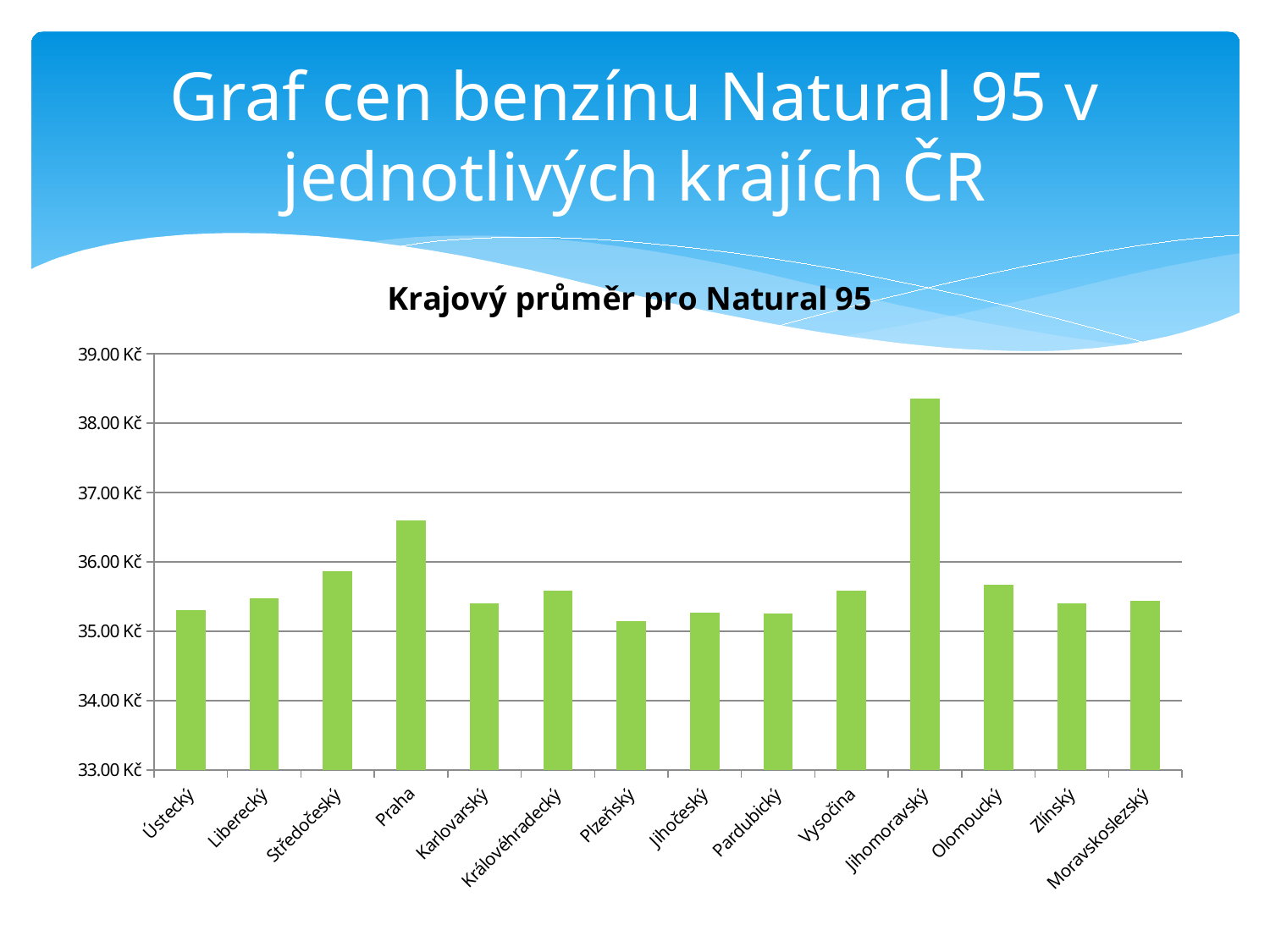
Is the value for Plzeňský greater or less than 35.00 Kč? greater Which is larger, the value for Jihomoravský or the value for Praha? Jihomoravský Is the value for Jihomoravský greater or less than 38.00 Kč? greater What colour are the bars in the chart? green Is the value for Ústecký greater or less than 36.00 Kč? less What is the title of the chart? Krajový průměr pro Natural 95 Which region has the highest average price for Natural 95? Jihomoravský How many regions (categories) are plotted on the x axis? 14 What kind of chart is shown on the slide? bar chart Which is larger, the value for Praha or the value for Středočeský? Praha